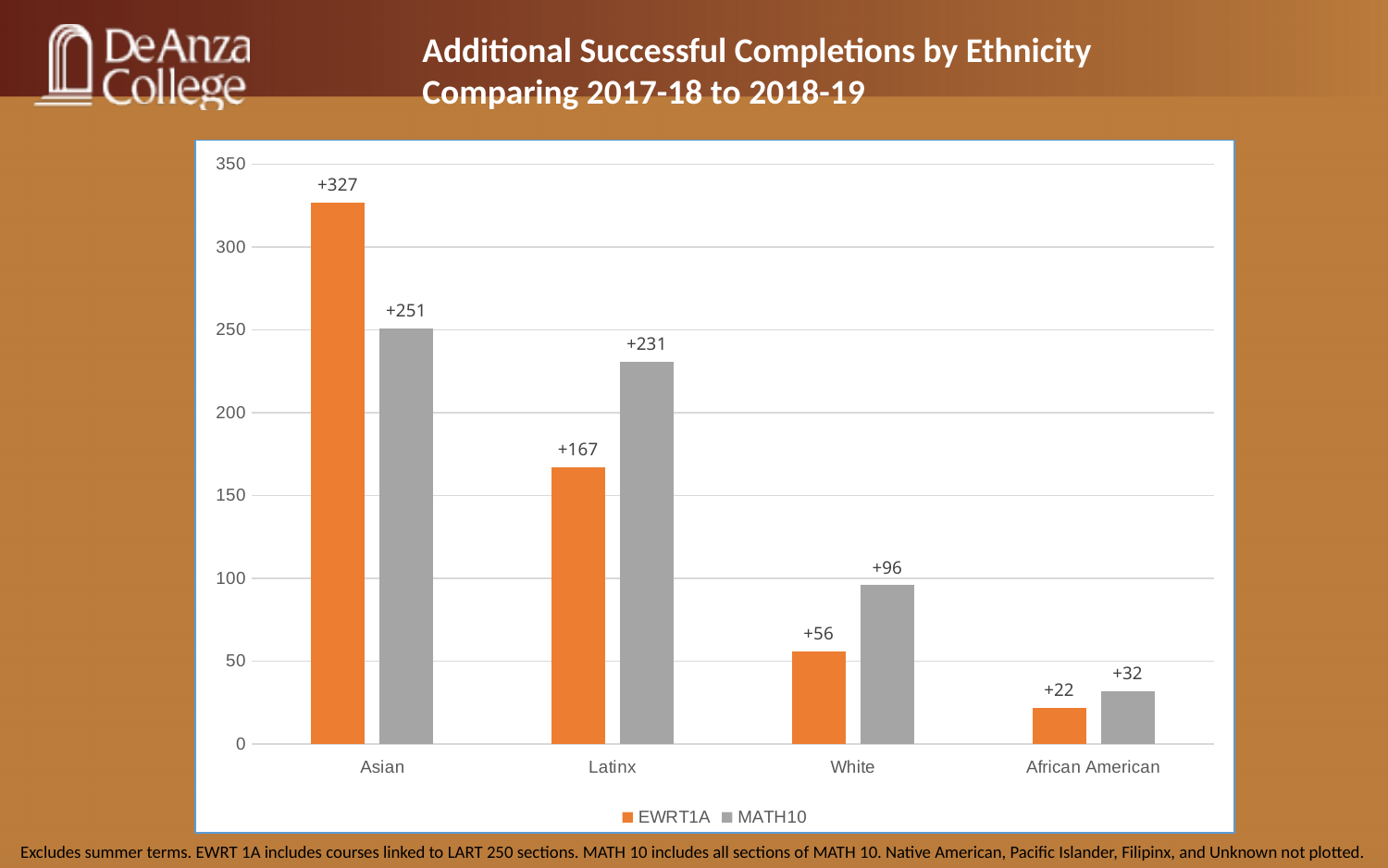
How many series does the legend list? 2 Is the MATH10 value for Asian greater or less than 300? less Which colour represents the EWRT1A series? orange Which is larger for Latinx, the EWRT1A value or the MATH10 value? MATH10 What is the difference between the EWRT1A and MATH10 values for White? 40 What kind of chart is shown on the slide? bar chart What is the MATH10 value for Latinx? +231 What is the EWRT1A value for Asian? +327 How many ethnicity categories are shown on the x axis? 4 Which ethnicity has the highest MATH10 value? Asian What is the EWRT1A value for African American? +22 Which ethnicity has the lowest EWRT1A value? African American